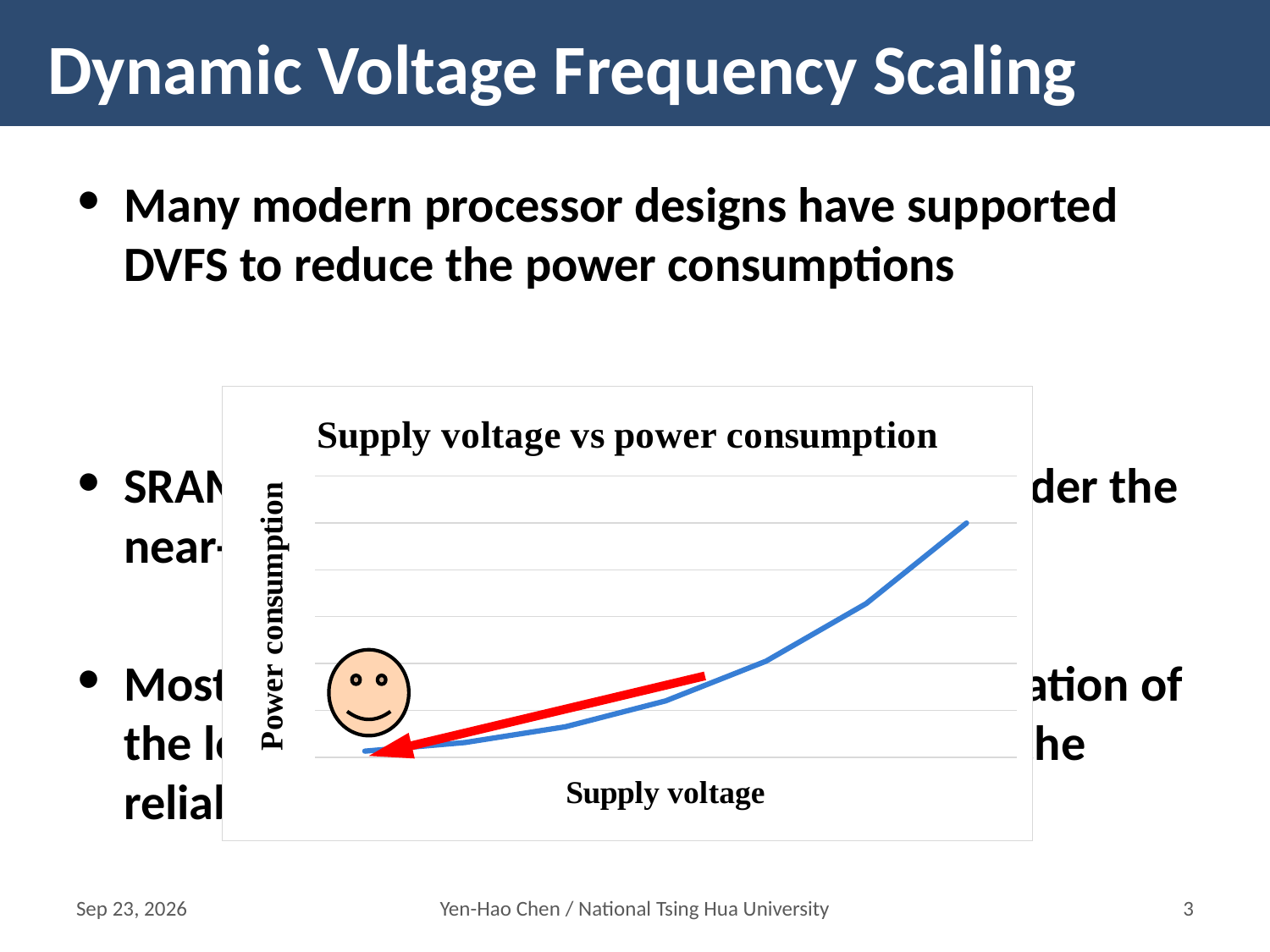
What is the title of the chart? Supply voltage vs power consumption As supply voltage increases along the x axis, does power consumption rise or fall? rise Is the curve steeper at the high end or the low end of the supply voltage axis? high end What kind of chart is shown on the slide? line chart What is the label of the x axis of the chart? Supply voltage How many data series are plotted in the chart? 1